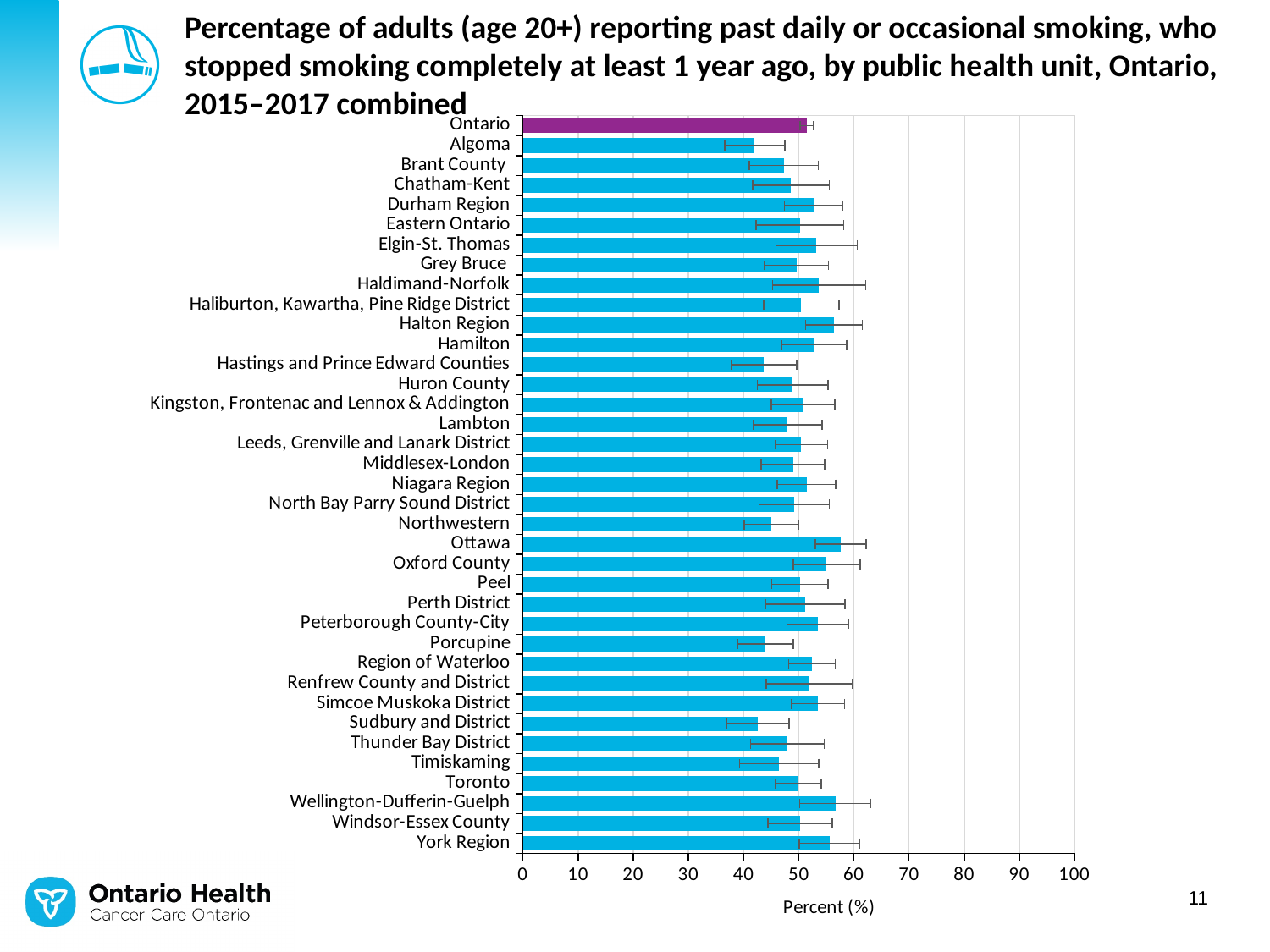
Is the value for Sudbury and District greater or less than 50? less How many public health units and regions (bars) are plotted in the chart? 37 Is the value for Halton Region greater or less than 50? greater Is the value for Algoma greater or less than 50? less What type of chart is shown on the slide? Bar chart What is the label on the horizontal axis of the chart? Percent (%) Which has the larger value, Ottawa or Algoma? Ottawa Which bar in the chart is shown in a different colour (purple) from the rest? Ontario Which has the larger value, Halton Region or Hastings and Prince Edward Counties? Halton Region